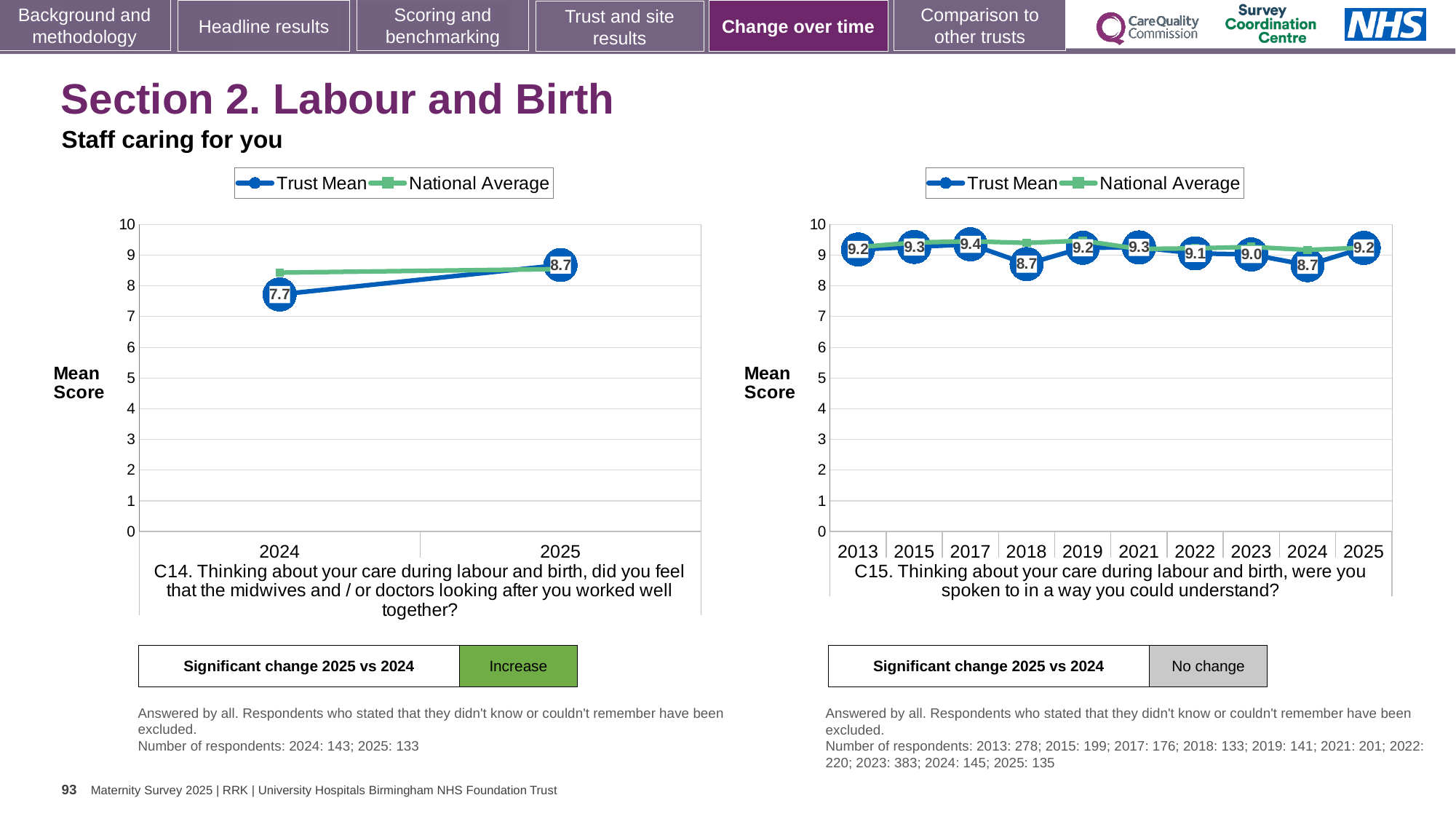
In the C15 chart on the right, what is the Trust Mean for 2018? 8.7 In the C15 chart on the right, which year has the highest Trust Mean? 2017 In the C14 chart on the left, what is the Trust Mean for 2025? 8.7 In the C14 chart on the left, what is the Trust Mean for 2024? 7.7 In the C15 chart on the right, which is larger, the Trust Mean for 2023 or for 2025? 2025 In the C15 chart on the right, what is the Trust Mean for 2017? 9.4 In the C14 chart on the left, is the National Average for 2024 greater or less than 8? greater What type of chart is the C14 chart on the left? Line chart In the C14 chart on the left, by how much did the Trust Mean change from 2024 to 2025? 1.0 In the C14 chart on the left, how many series does the legend list? 2 In the C15 chart on the right, what is the difference between the Trust Mean for 2017 and for 2024? 0.7 In the C15 chart on the right, how many years are plotted on the x axis? 10